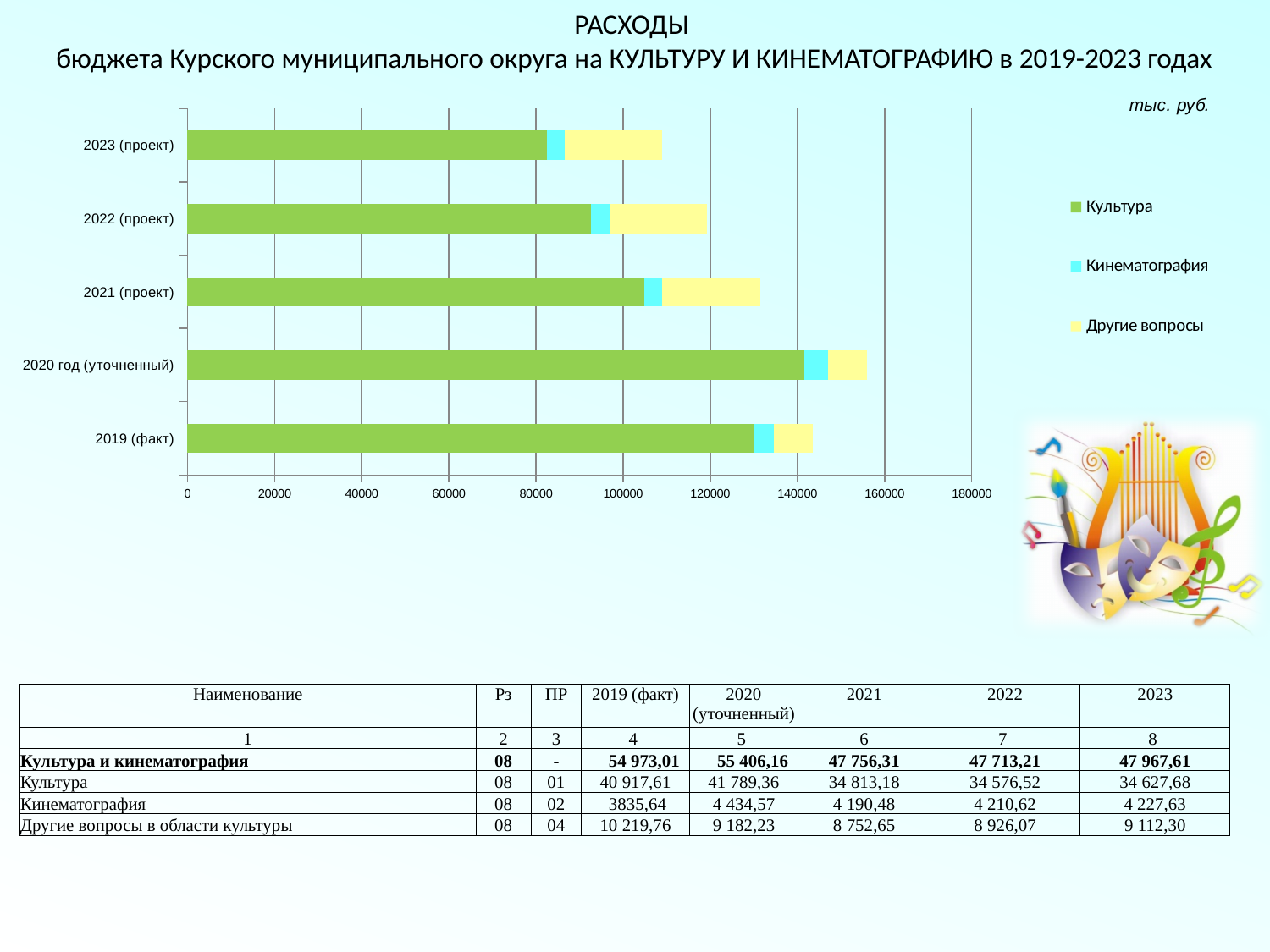
What unit is indicated for the chart values? тыс. руб. Is the total stacked bar for 2023 (проект) greater or less than 120000? less Which year has the longest total stacked bar? 2020 год (уточненный) How many series does the chart legend list? 3 What kind of chart is shown on the slide? bar chart Does the Культура segment rise or fall from 2020 год (уточненный) through 2023 (проект)? fall Is the Культура value for 2020 год (уточненный) greater or less than 120000? greater What are the three series named in the chart legend? Культура, Кинематография, Другие вопросы Is the Культура value for 2023 (проект) greater or less than 100000? less How many year categories are plotted on the chart? 5 Which is larger, the Культура value for 2019 (факт) or for 2021 (проект)? 2019 (факт) Which year has the shortest total stacked bar? 2023 (проект)